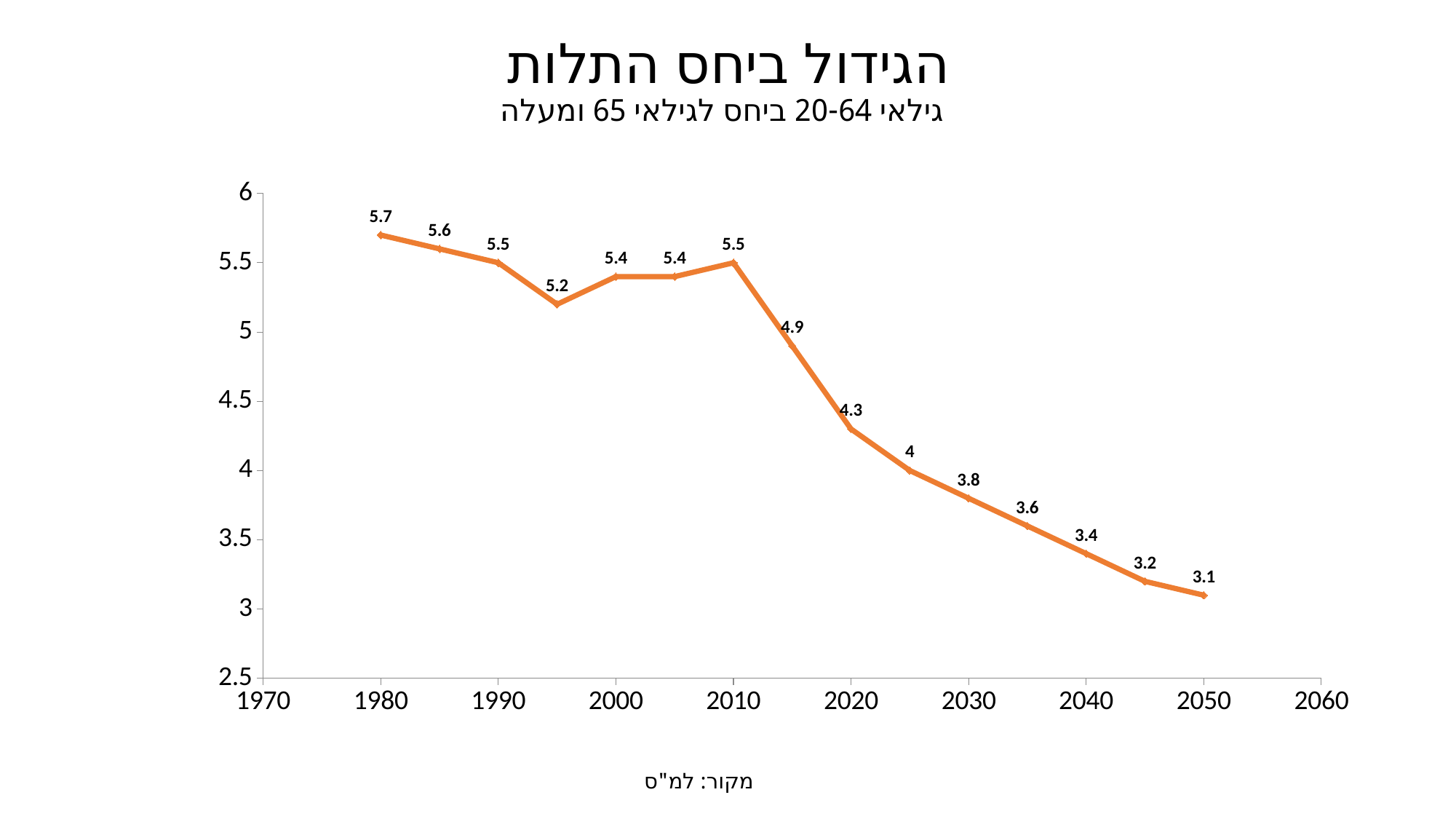
What type of chart is shown on the slide? line chart Which year has the highest plotted value? 1980 What is the difference between the values for 1980 and 2050? 2.6 What is the title of the chart? הגידול ביחס התלות How many data points are plotted on the line? 15 Which is larger, the value for 2010 or the value for 2015? 2010 Which year has the lowest plotted value? 2050 What is the value plotted for 2050? 3.1 What is the value plotted for 1980? 5.7 What is the value plotted for 1995? 5.2 Do the values generally rise or fall from 2010 to 2050? fall What is the value plotted for 2020? 4.3